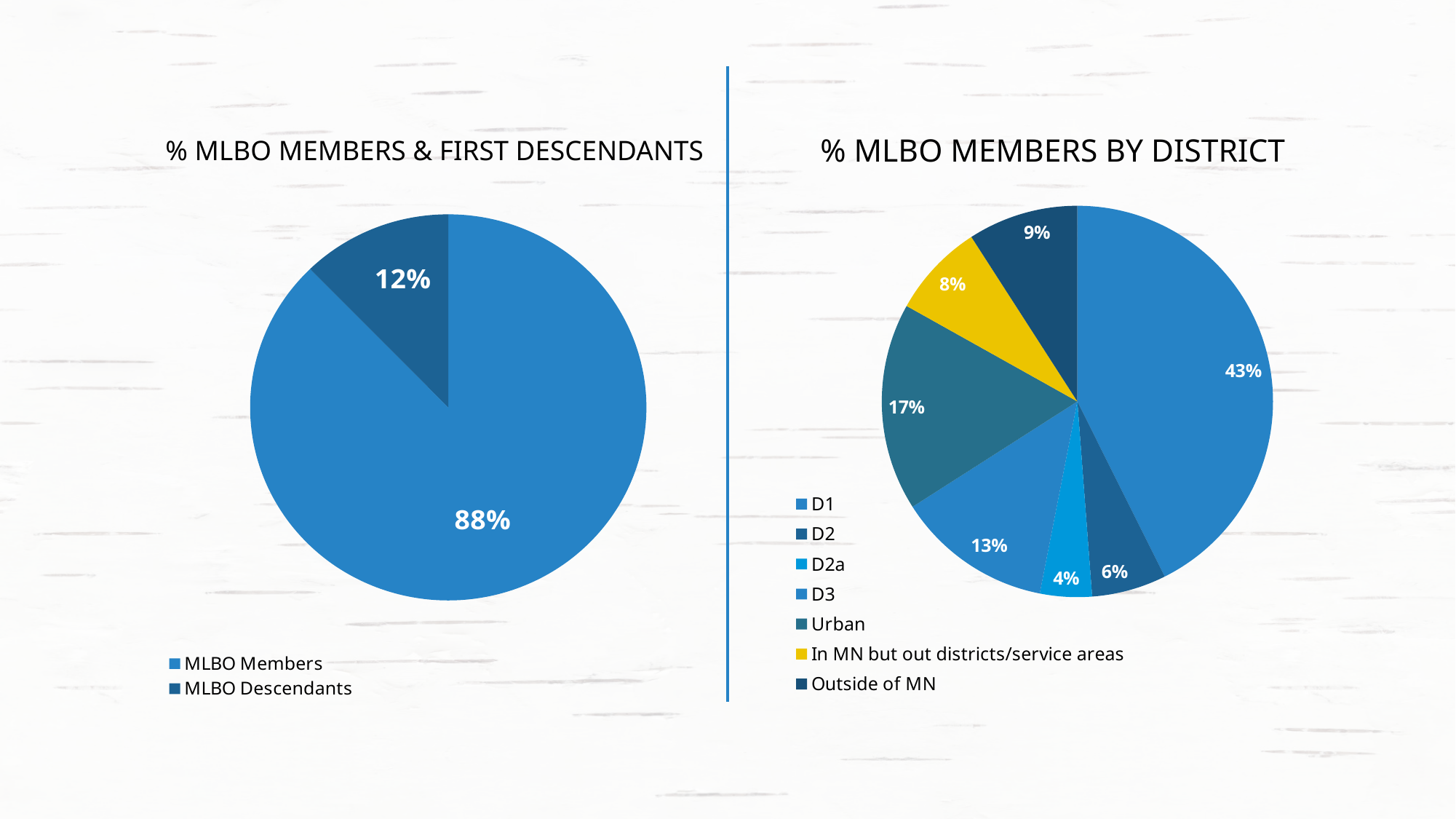
How many categories does the legend of the '% MLBO MEMBERS BY DISTRICT' chart list? 7 What kind of chart is the '% MLBO MEMBERS & FIRST DESCENDANTS' chart? Pie chart In the '% MLBO MEMBERS BY DISTRICT' chart, what share is Urban? 17% In the '% MLBO MEMBERS BY DISTRICT' chart, which category has the largest share? D1 In the '% MLBO MEMBERS & FIRST DESCENDANTS' chart, what share is MLBO Members? 88% In the '% MLBO MEMBERS BY DISTRICT' chart, what share is D1? 43% How many categories does the legend of the '% MLBO MEMBERS & FIRST DESCENDANTS' chart list? 2 In the '% MLBO MEMBERS BY DISTRICT' chart, which is larger, Urban or D3? Urban In the '% MLBO MEMBERS BY DISTRICT' chart, what is the difference between the D3 share and the D2 share? 7% In the '% MLBO MEMBERS BY DISTRICT' chart, which category has the smallest share? D2a